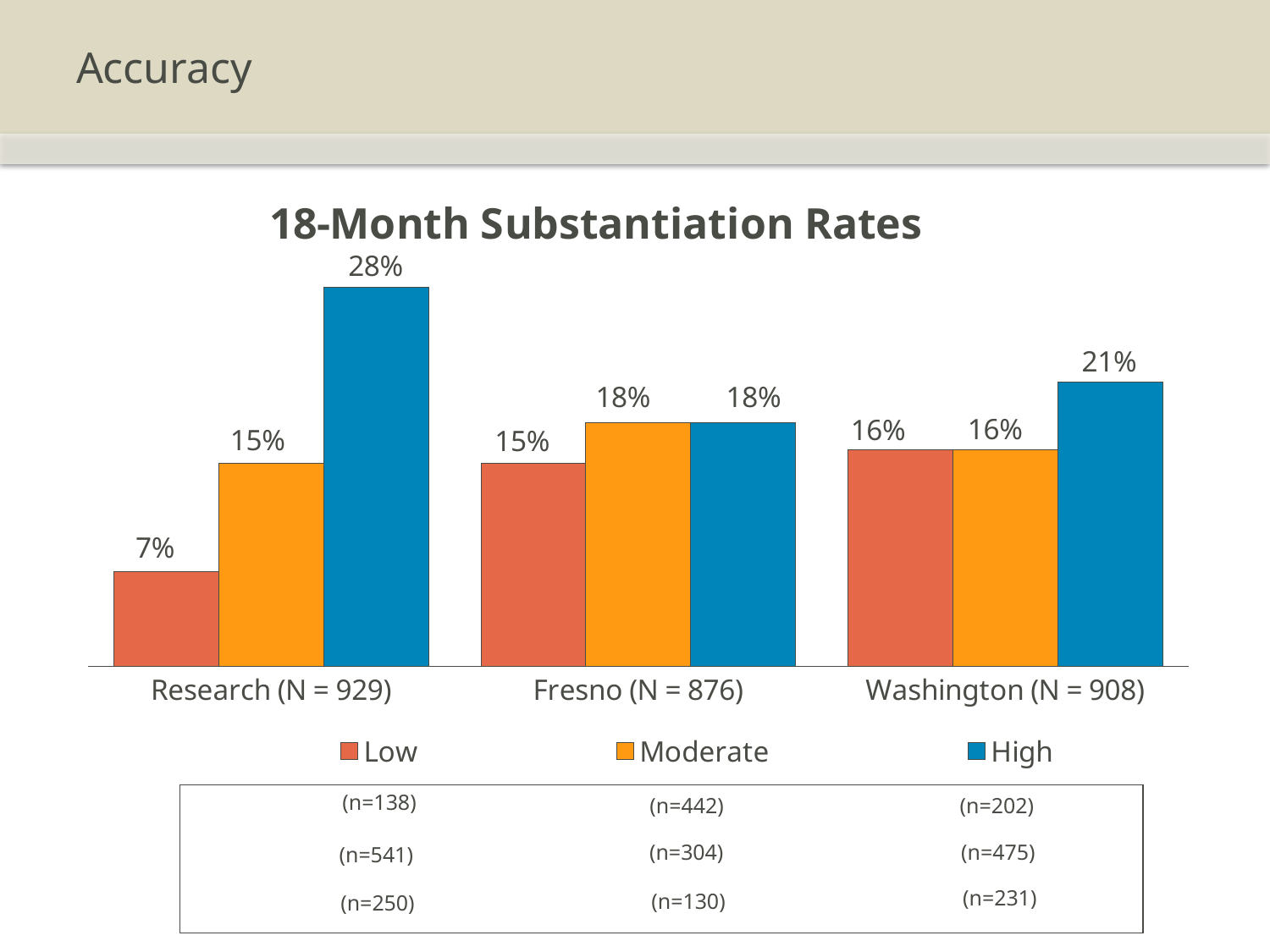
What kind of chart is shown on the slide? Bar chart What is the title of the chart? 18-Month Substantiation Rates What is the difference between the High rates for Research (N = 929) and Washington (N = 908)? 7% What is the 18-month substantiation rate for the High group in Research (N = 929)? 28% How many series does the legend list? 3 What is the difference between the High and Low substantiation rates in Research (N = 929)? 21% What is the substantiation rate for the Moderate group in Washington (N = 908)? 16% Which site has the highest substantiation rate for the High group? Research (N = 929) Which site has the lowest substantiation rate for the Low group? Research (N = 929) How many sites (categories) are shown on the x axis? 3 What is the substantiation rate for the Low group in Fresno (N = 876)? 15% Which is larger, the Moderate rate in Fresno (N = 876) or the Moderate rate in Washington (N = 908)? Fresno (N = 876)